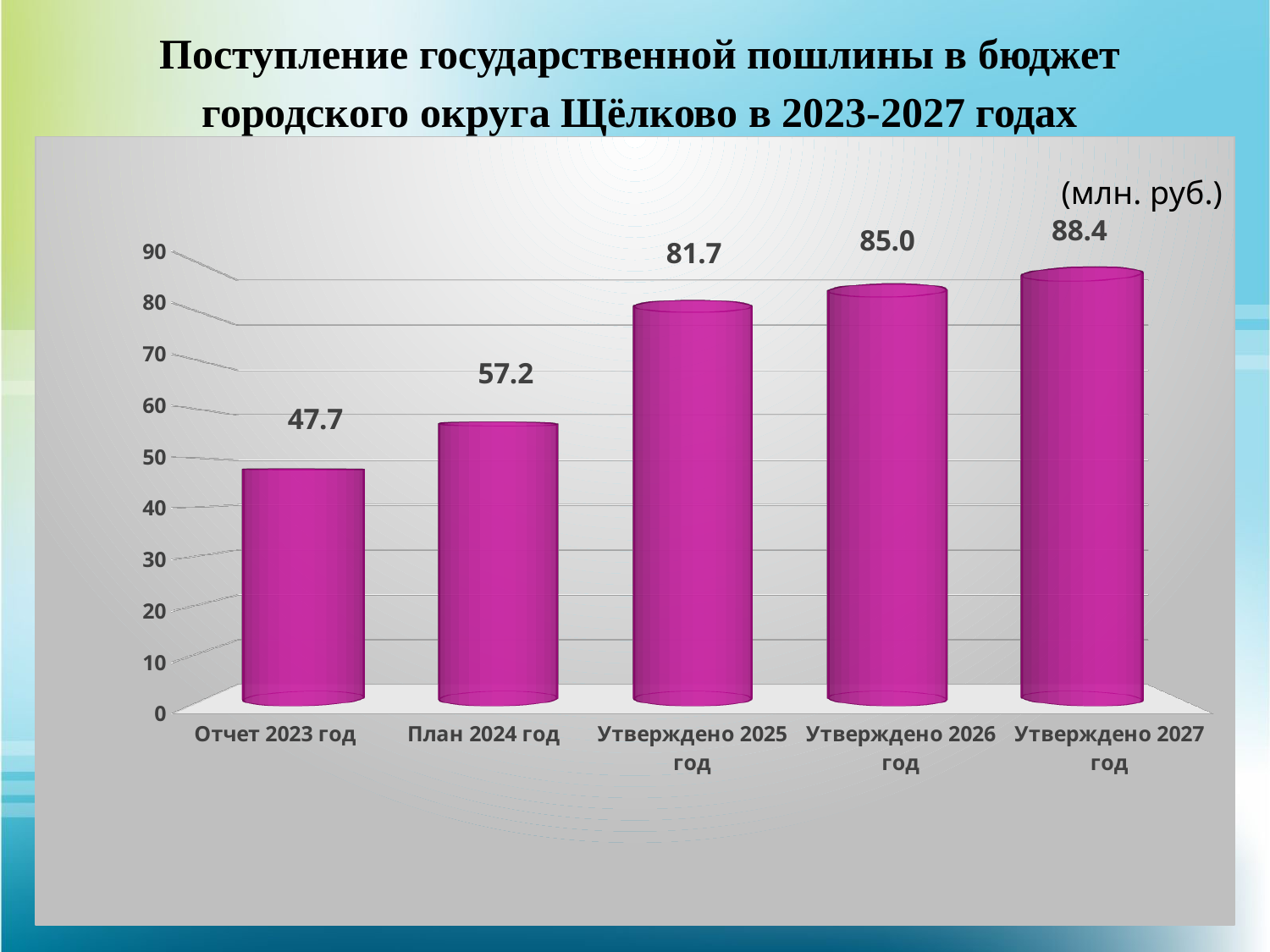
How many categories are shown on the chart? 5 Which category has the highest value? Утверждено 2027 год What is the value for Утверждено 2027 год? 88.4 Do the values rise or fall from left to right along the x axis? Rise Which category has the lowest value? Отчет 2023 год What is the difference between the values for Утверждено 2026 год and Утверждено 2025 год? 3.3 Which is larger, the value for План 2024 год or the value for Утверждено 2025 год? Утверждено 2025 год What is the difference between the values for Утверждено 2027 год and Отчет 2023 год? 40.7 What is the value for Отчет 2023 год? 47.7 What kind of chart is shown on the slide? Bar chart What is the value for План 2024 год? 57.2 What is the value for Утверждено 2025 год? 81.7